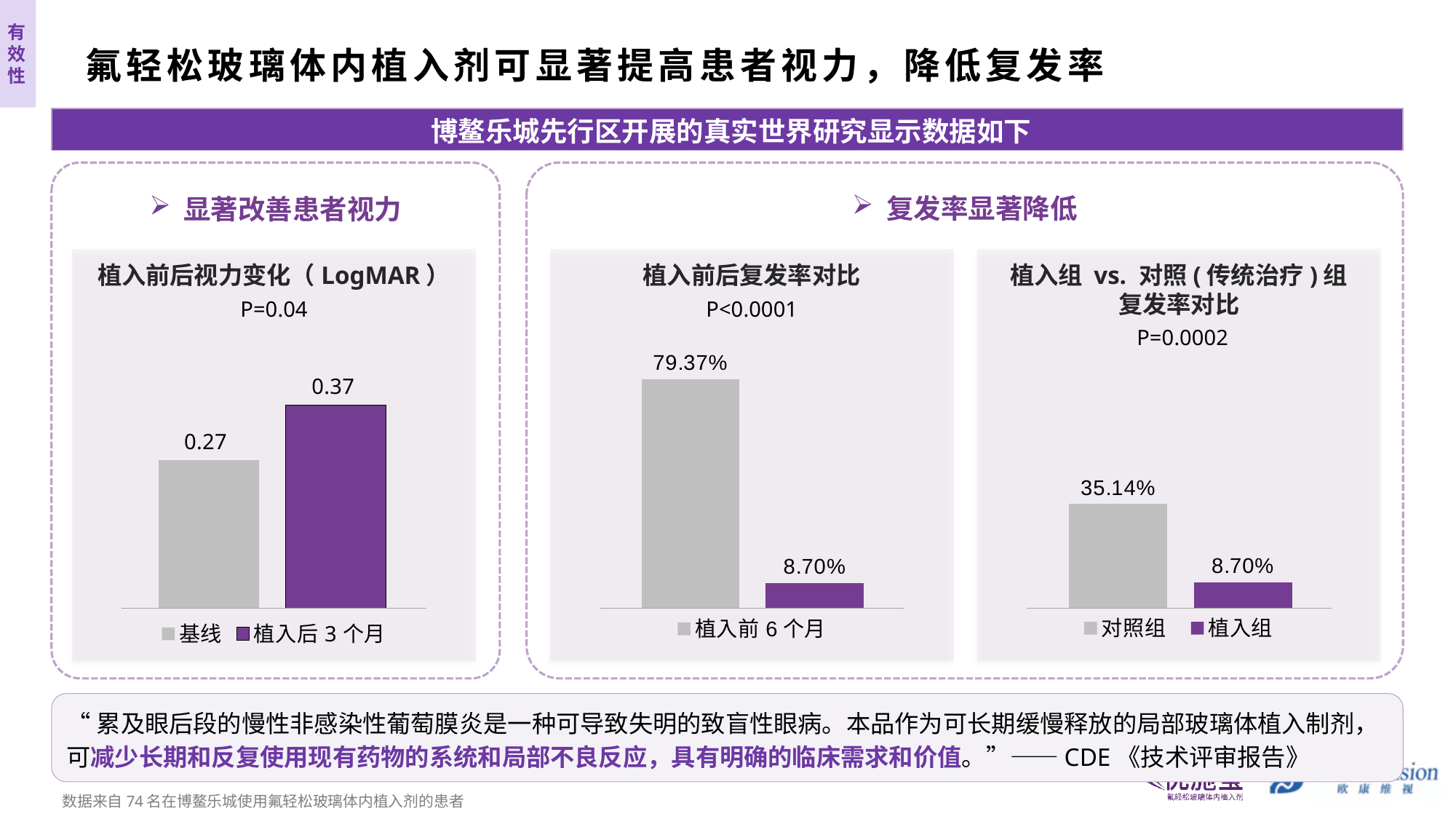
In the chart titled 植入前后复发率对比, what is the value of the purple bar? 8.70% In the chart titled 植入前后视力变化（LogMAR）, what is the value for 基线? 0.27 In the chart titled 植入前后视力变化（LogMAR）, which is larger, 基线 or 植入后 3 个月? 植入后 3 个月 In the chart titled 植入组 vs. 对照(传统治疗)组 复发率对比, which group has the lower value? 植入组 In the chart titled 植入前后复发率对比, what is the value for 植入前 6 个月? 79.37% What kind of chart is the chart titled 植入组 vs. 对照(传统治疗)组 复发率对比? Bar chart In the chart titled 植入前后复发率对比, what is the difference between the two bars? 70.67% In the chart titled 植入组 vs. 对照(传统治疗)组 复发率对比, what is the value for 对照组? 35.14% In the chart titled 植入前后视力变化（LogMAR）, how many series does the legend list? 2 In the chart titled 植入前后视力变化（LogMAR）, what is the value for 植入后 3 个月? 0.37 In the chart titled 植入前后视力变化（LogMAR）, what is the difference between the 植入后 3 个月 value and the 基线 value? 0.10 In the chart titled 植入组 vs. 对照(传统治疗)组 复发率对比, what is the value for 植入组? 8.70%